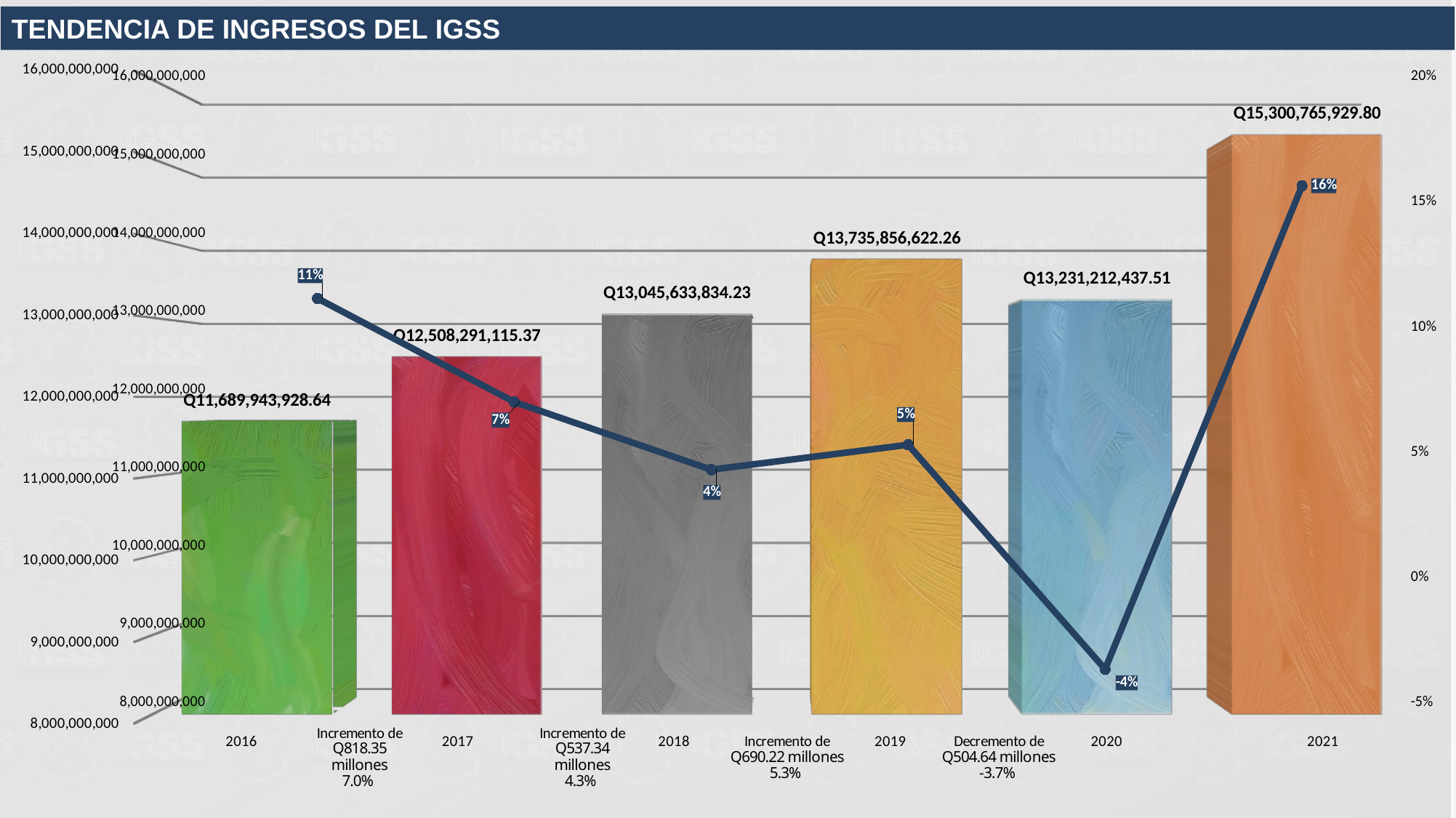
Which year has the lowest income bar? 2016 What is the income value shown for 2016? Q11,689,943,928.64 Which year has the highest income bar? 2021 Which is larger, the income bar for 2019 or the income bar for 2020? 2019 Which year has the lowest value on the percentage line? 2020 What percentage does the line show for 2020? -4% How many years are shown on the x axis? 6 Is the income value for 2018 greater or less than 13,000,000,000? greater What percentage does the line show for 2021? 16% What is the difference between the income for 2021 and the income for 2020? Q2,069,553,492.29 What is the title of the chart? TENDENCIA DE INGRESOS DEL IGSS What is the income value shown for 2021? Q15,300,765,929.80